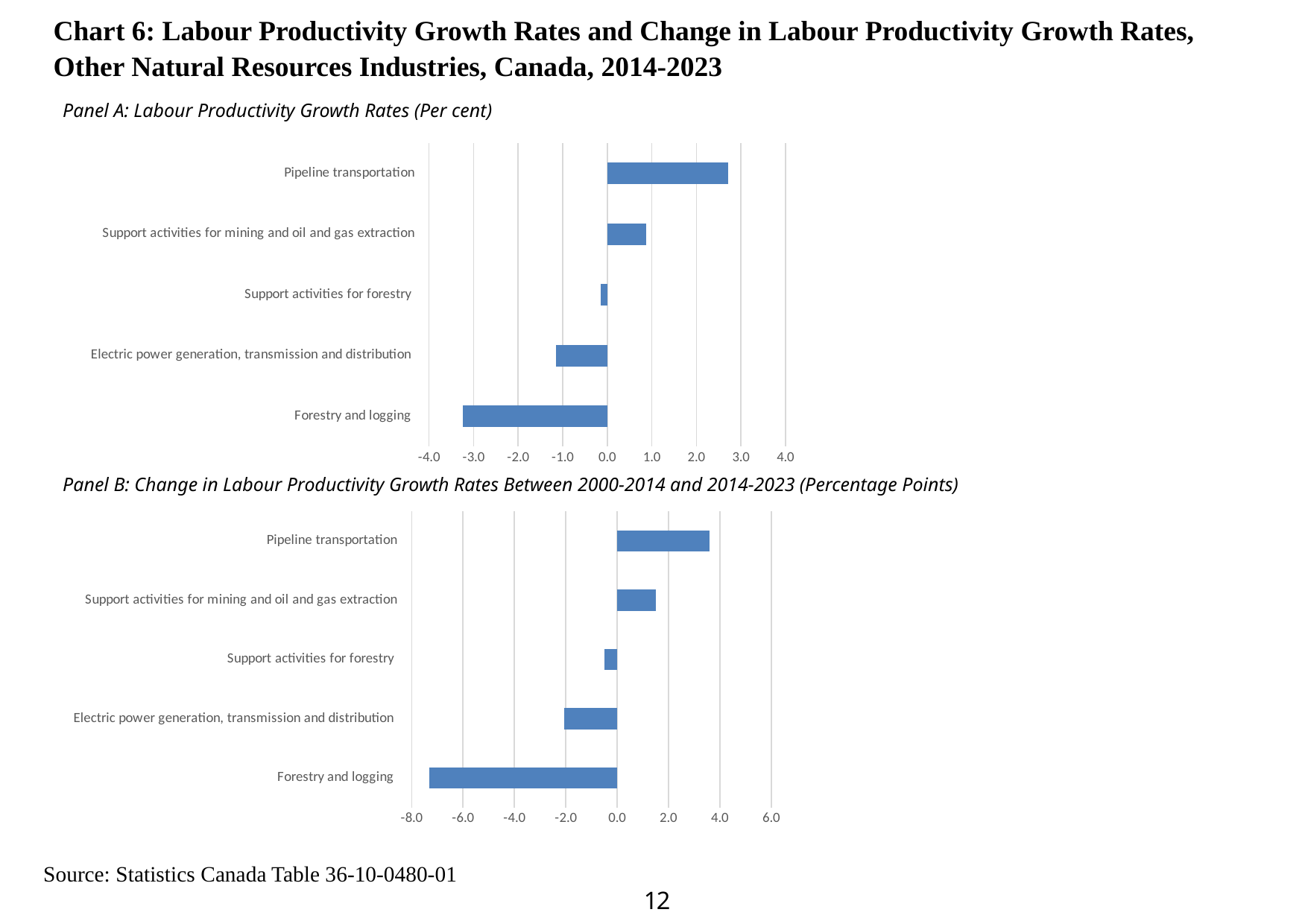
In Panel B: Change in Labour Productivity Growth Rates, which industry has the largest decline? Forestry and logging In Panel A: Labour Productivity Growth Rates, which industry has the highest growth rate? Pipeline transportation In Panel A: Labour Productivity Growth Rates, is the value for Electric power generation, transmission and distribution greater or less than 0.0? less In Panel B: Change in Labour Productivity Growth Rates, which industry has the largest increase? Pipeline transportation In Panel A: Labour Productivity Growth Rates, which industry has the lowest growth rate? Forestry and logging In Panel B: Change in Labour Productivity Growth Rates, which is larger, the value for Pipeline transportation or the value for Support activities for mining and oil and gas extraction? Pipeline transportation How many industries are shown in Panel A: Labour Productivity Growth Rates? 5 In Panel B: Change in Labour Productivity Growth Rates, is the value for Forestry and logging greater or less than -6.0? less In Panel A: Labour Productivity Growth Rates, is the value for Pipeline transportation greater or less than 2.0? greater What unit is used in Panel B: Change in Labour Productivity Growth Rates, according to its subtitle? Percentage Points What type of chart is Panel A: Labour Productivity Growth Rates? bar chart